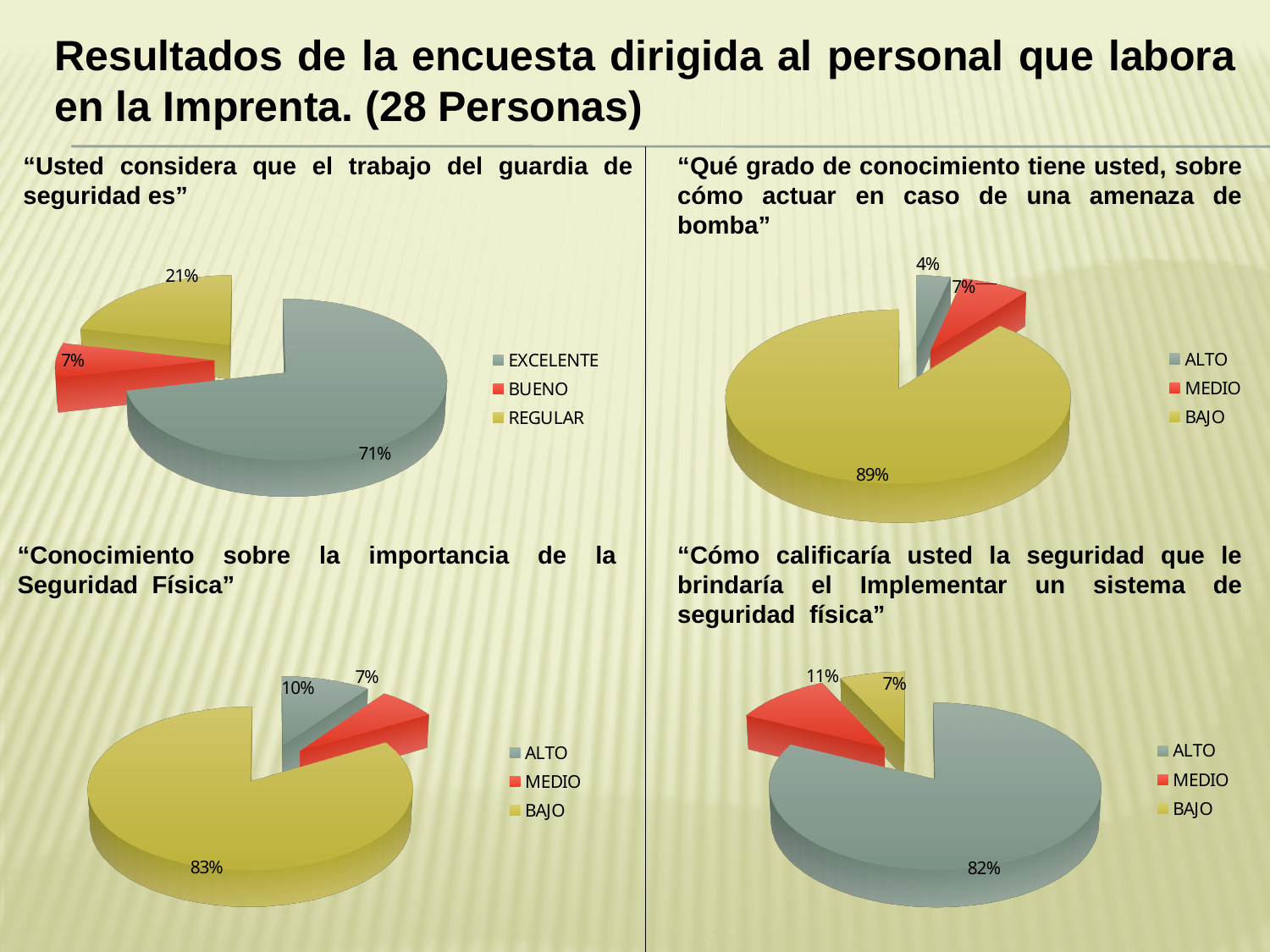
What type of chart is used for the bottom-right chart on the slide? Pie chart In the top-right pie chart (knowledge of how to act in a bomb threat), what is the difference between the BAJO and MEDIO shares? 82% In the top-right pie chart (knowledge of how to act in a bomb threat), what share is labelled ALTO? 4% In the top-left pie chart (work of the security guard), which category has the smallest share? BUENO In the bottom-right pie chart (security from implementing a physical security system), what share is labelled ALTO? 82% In the bottom-left pie chart (importance of physical security), which category has the largest share? BAJO In the bottom-left pie chart (importance of physical security), what share is labelled ALTO? 10% In the top-right pie chart (knowledge of how to act in a bomb threat), what share is labelled BAJO? 89% In the top-left pie chart (work of the security guard), what share is labelled EXCELENTE? 71% In the bottom-right pie chart (security from implementing a physical security system), which is larger, MEDIO or BAJO? MEDIO In the top-left pie chart (work of the security guard), what share is labelled REGULAR? 21% How many categories does the legend of the top-left pie chart list? 3